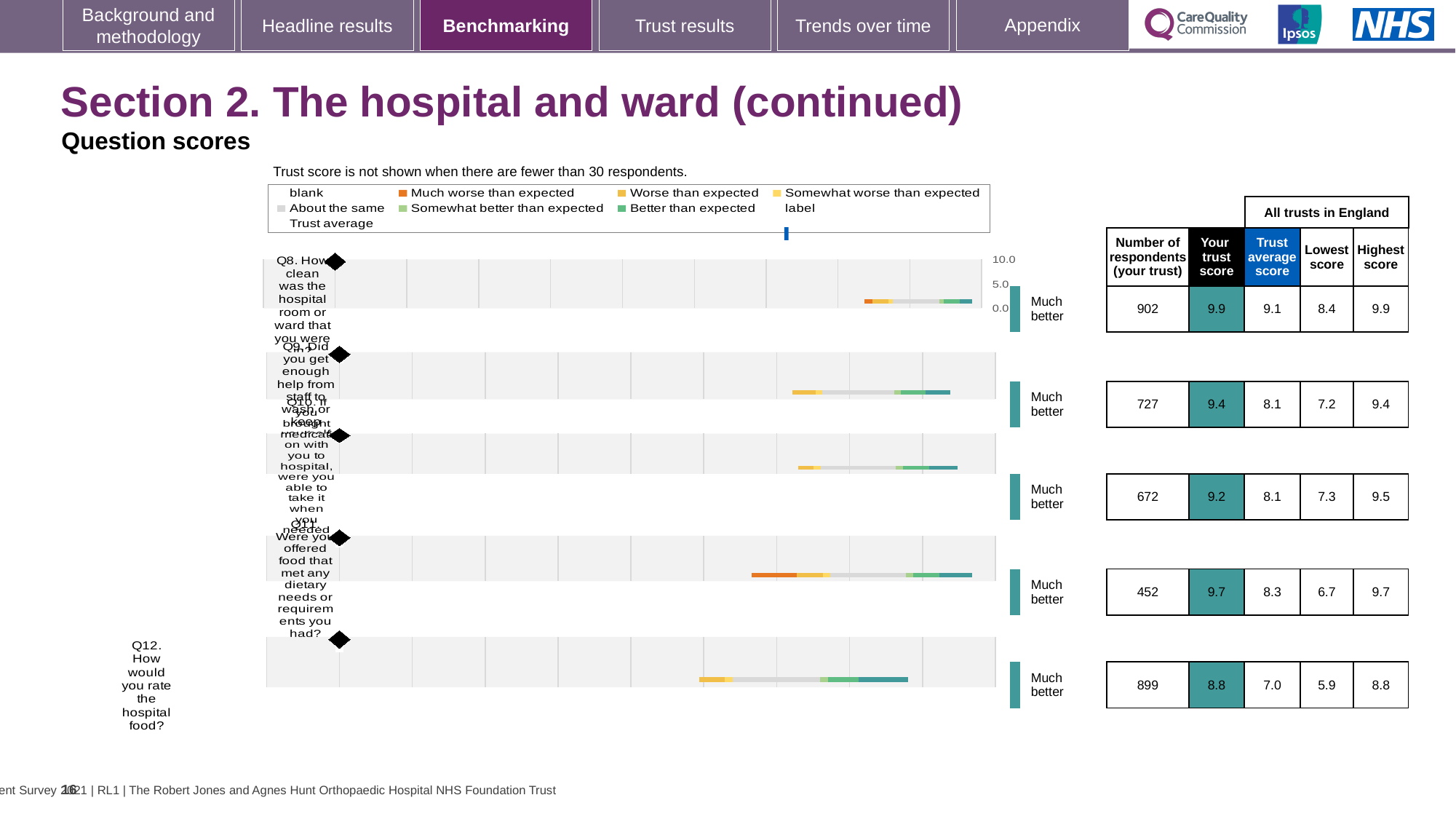
What kind of chart is used to show the question scores? Bar chart What rating label is shown next to each question's bar? Much better What colour does the legend use for 'Much worse than expected'? Orange For Q11, what is the difference between the highest score and the lowest score across all trusts in England? 3.0 Which question has the lowest 'Lowest score' across all trusts in England? Q12 Which has the higher 'Your trust score', Q9 or Q10? Q9 For Q12, what is the difference between 'Your trust score' and the trust average score? 1.8 How many questions are plotted in the benchmarking chart? 5 Which question has the highest 'Your trust score'? Q8 What is the trust average score for Q11 (Were you offered food that met any dietary needs or requirements you had)? 8.3 What is the 'Your trust score' for Q8 (How clean was the hospital room or ward)? 9.9 How many respondents from your trust answered Q12 (How would you rate the hospital food)? 899